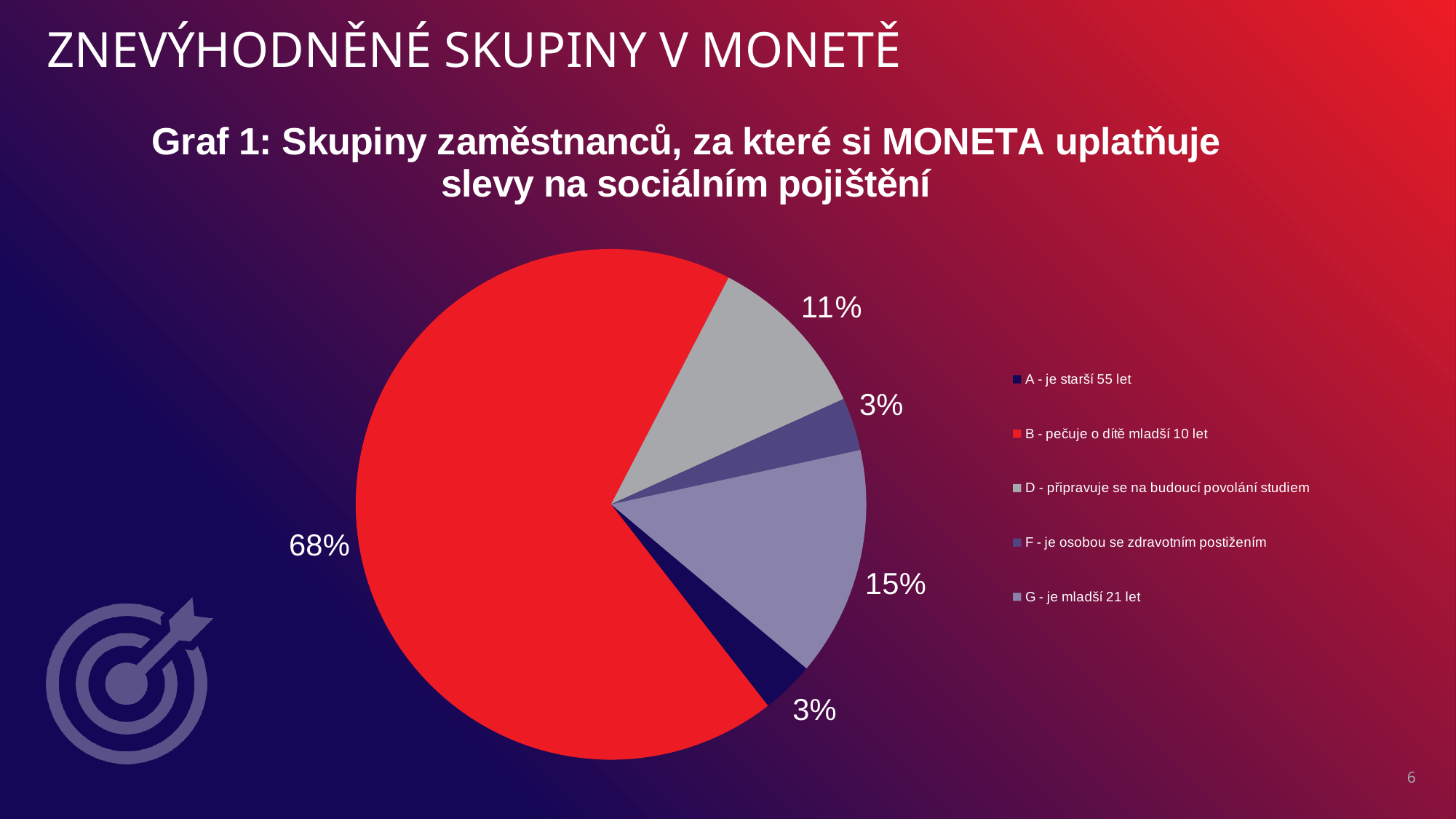
What colour is the slice for 'B - pečuje o dítě mladší 10 let'? red Which slice is larger: 'D - připravuje se na budoucí povolání studiem' or 'G - je mladší 21 let'? G - je mladší 21 let How many slices does the pie chart have? 5 What share of the pie does 'A - je starší 55 let' have? 3% What share of the pie does 'G - je mladší 21 let' have? 15% What share of the pie does 'B - pečuje o dítě mladší 10 let' have? 68% What is the title of the chart? Graf 1: Skupiny zaměstnanců, za které si MONETA uplatňuje slevy na sociálním pojištění What is the difference in percentage points between 'B - pečuje o dítě mladší 10 let' and 'G - je mladší 21 let'? 53 What share of the pie does 'D - připravuje se na budoucí povolání studiem' have? 11% Which group has the largest slice of the pie? B - pečuje o dítě mladší 10 let What kind of chart is shown on the slide? pie chart What share of the pie does 'F - je osobou se zdravotním postižením' have? 3%